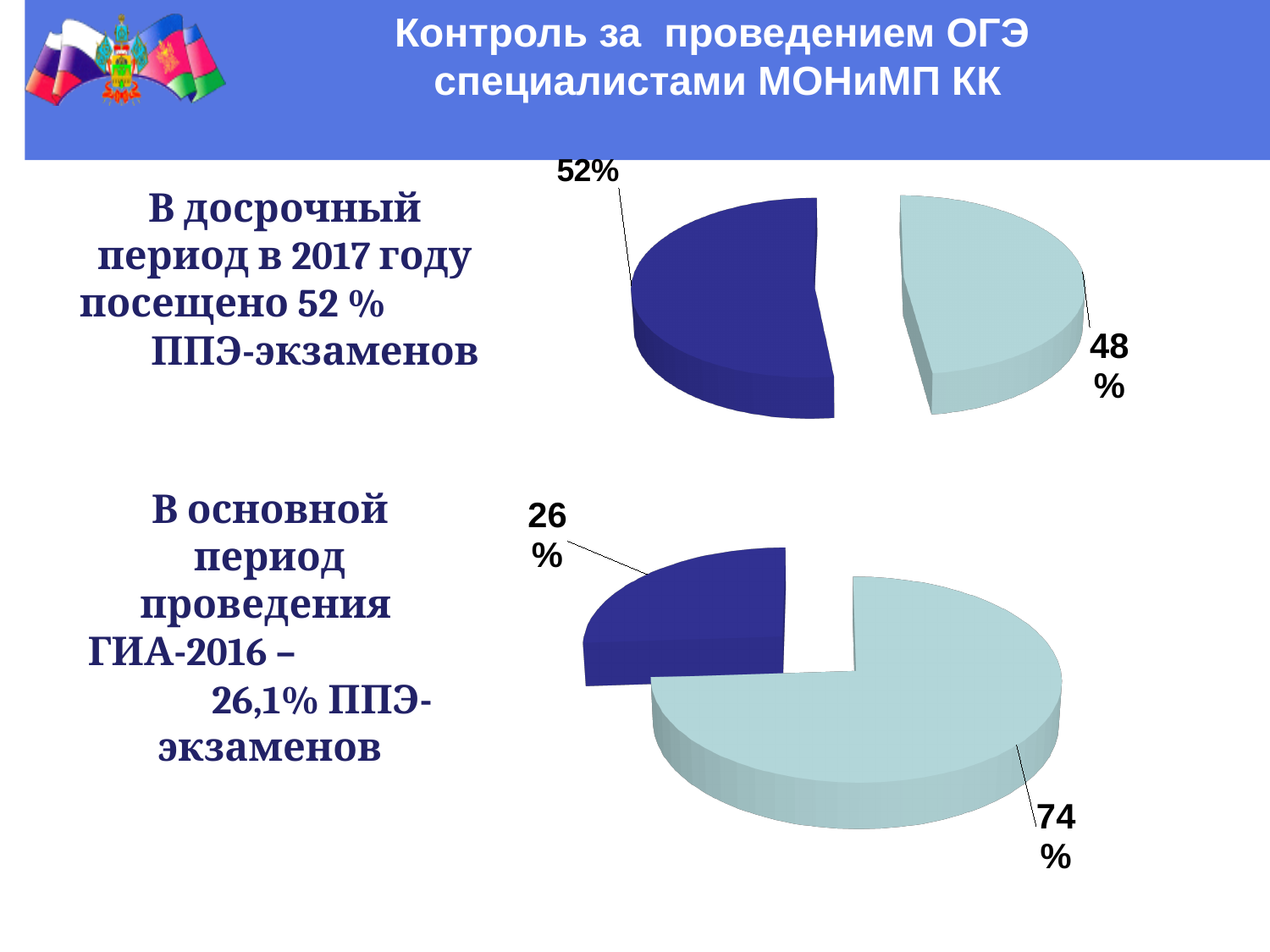
In the top pie chart, how many slices are there? 2 In the top pie chart, what share is shown for the light blue slice? 48% In the bottom pie chart, what share is shown for the light blue slice? 74% In the top pie chart, what share is shown for the dark blue slice? 52% What kind of chart is the bottom chart on the slide? pie chart Which is larger: the dark blue slice in the top pie chart or the dark blue slice in the bottom pie chart? the dark blue slice in the top pie chart (52%) In the top pie chart, which slice is the smallest? the light blue slice (48%) In the bottom pie chart, what is the difference between the light blue slice and the dark blue slice? 48% What kind of chart is the top chart on the slide? pie chart In the bottom pie chart, which slice is the largest? the light blue slice (74%) In the bottom pie chart, how many slices are there? 2